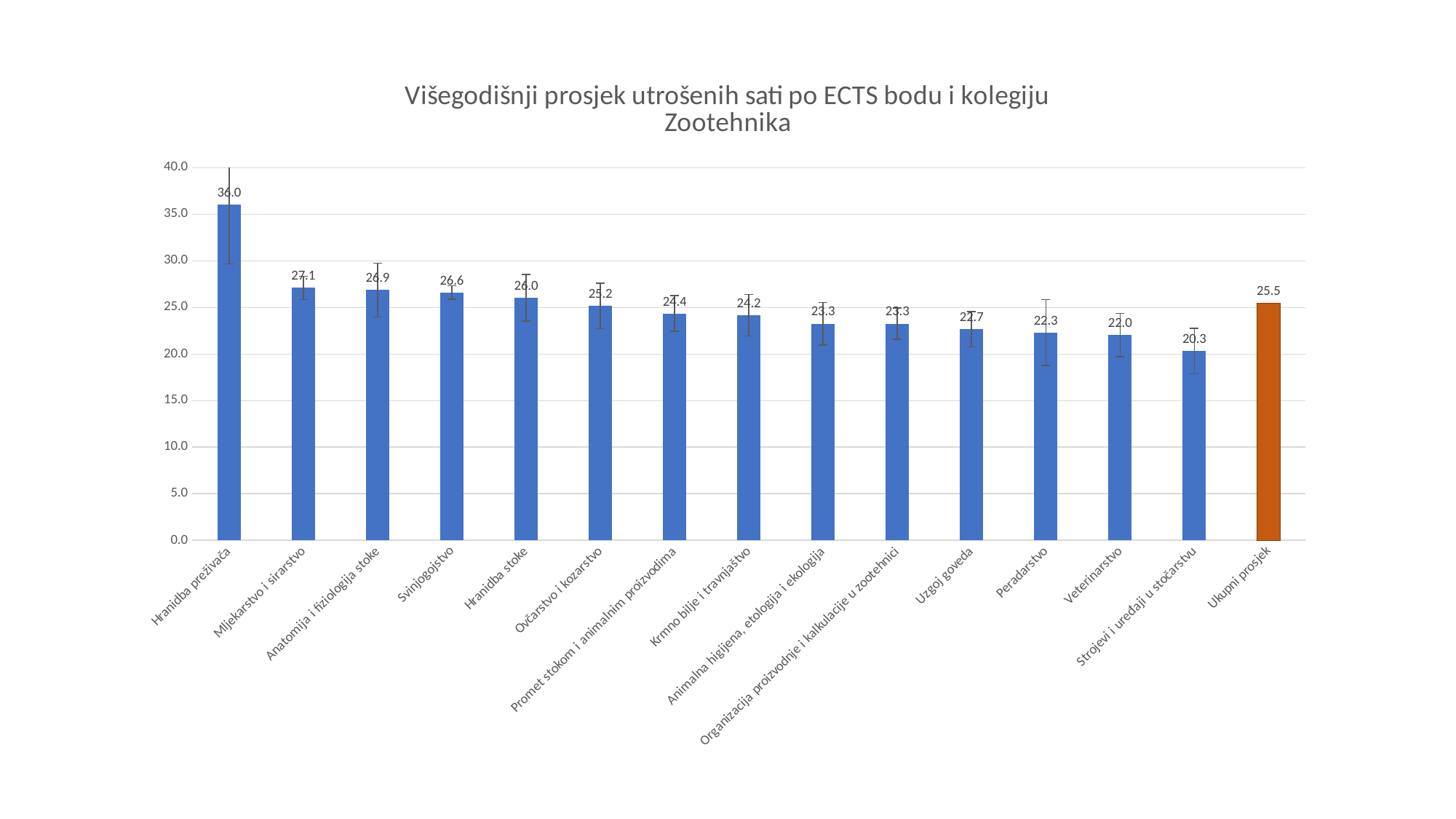
Which category has the lowest value? Strojevi i uređaji u stočarstvu Is the value for Uzgoj goveda greater or less than 25.0? less What is the value for Svinjogojstvo? 26.6 How many bars are plotted in the chart? 15 What is the value for Strojevi i uređaji u stočarstvu? 20.3 What is the difference between the values for Hranidba preživača and Mljekarstvo i sirarstvo? 8.9 Which bar is shown in a different colour (orange) from the others? Ukupni prosjek What kind of chart is shown on the slide? bar chart Which category has the highest value? Hranidba preživača Which is larger, the value for Peradarstvo or the value for Veterinarstvo? Peradarstvo What is the value for Hranidba preživača? 36.0 What is the value for Ukupni prosjek? 25.5